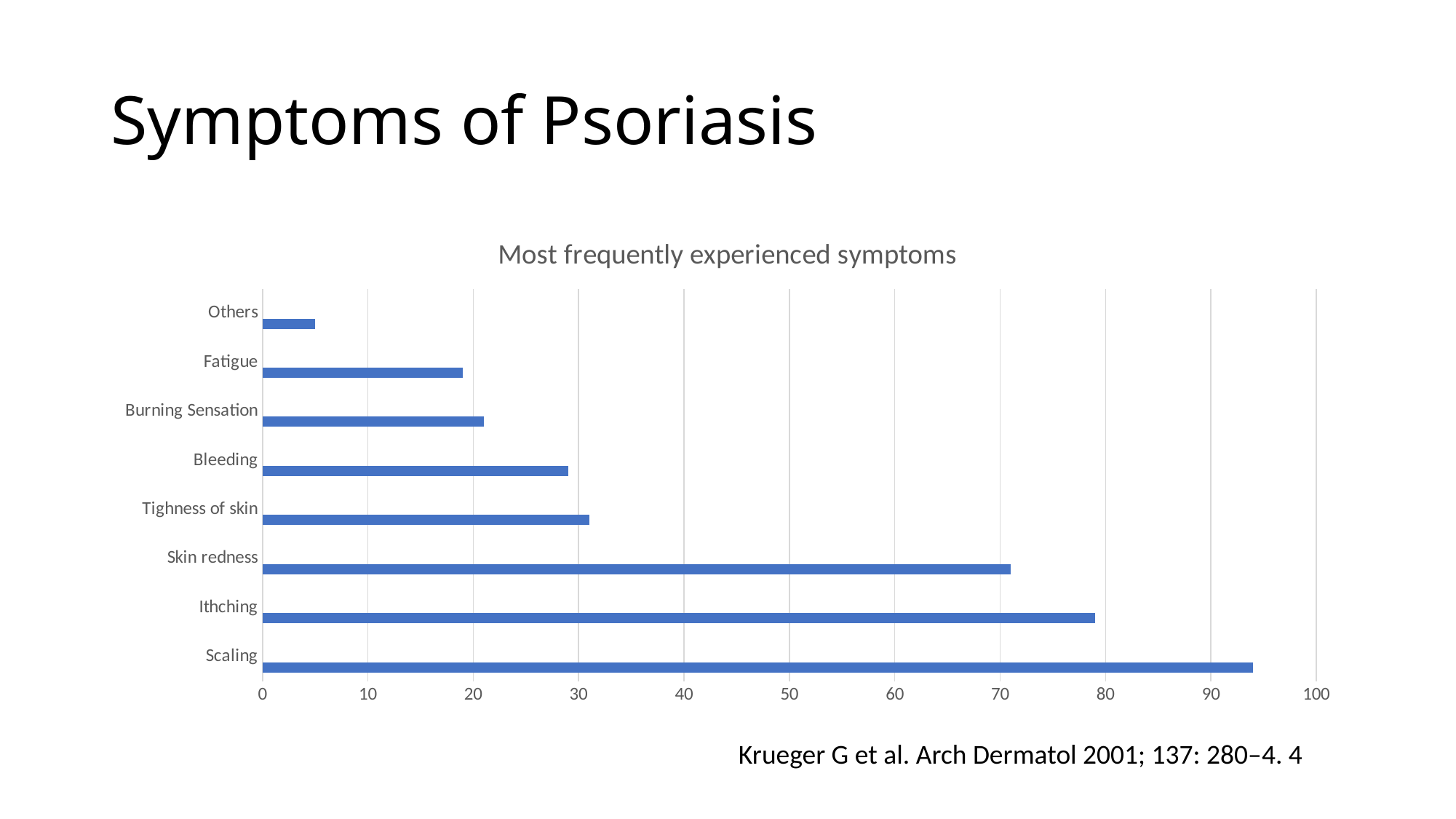
What is the title of the chart? Most frequently experienced symptoms Which symptom has the highest value in the chart? Scaling How many symptom categories are plotted in the chart? 8 Is the value for Others greater or less than 10? less Is the value for Scaling greater or less than 90? greater Which has a larger value, Itching or Skin redness? Itching Which has a larger value, Fatigue or Bleeding? Bleeding Which symptom has the lowest value in the chart? Others What kind of chart is shown on the slide? bar chart